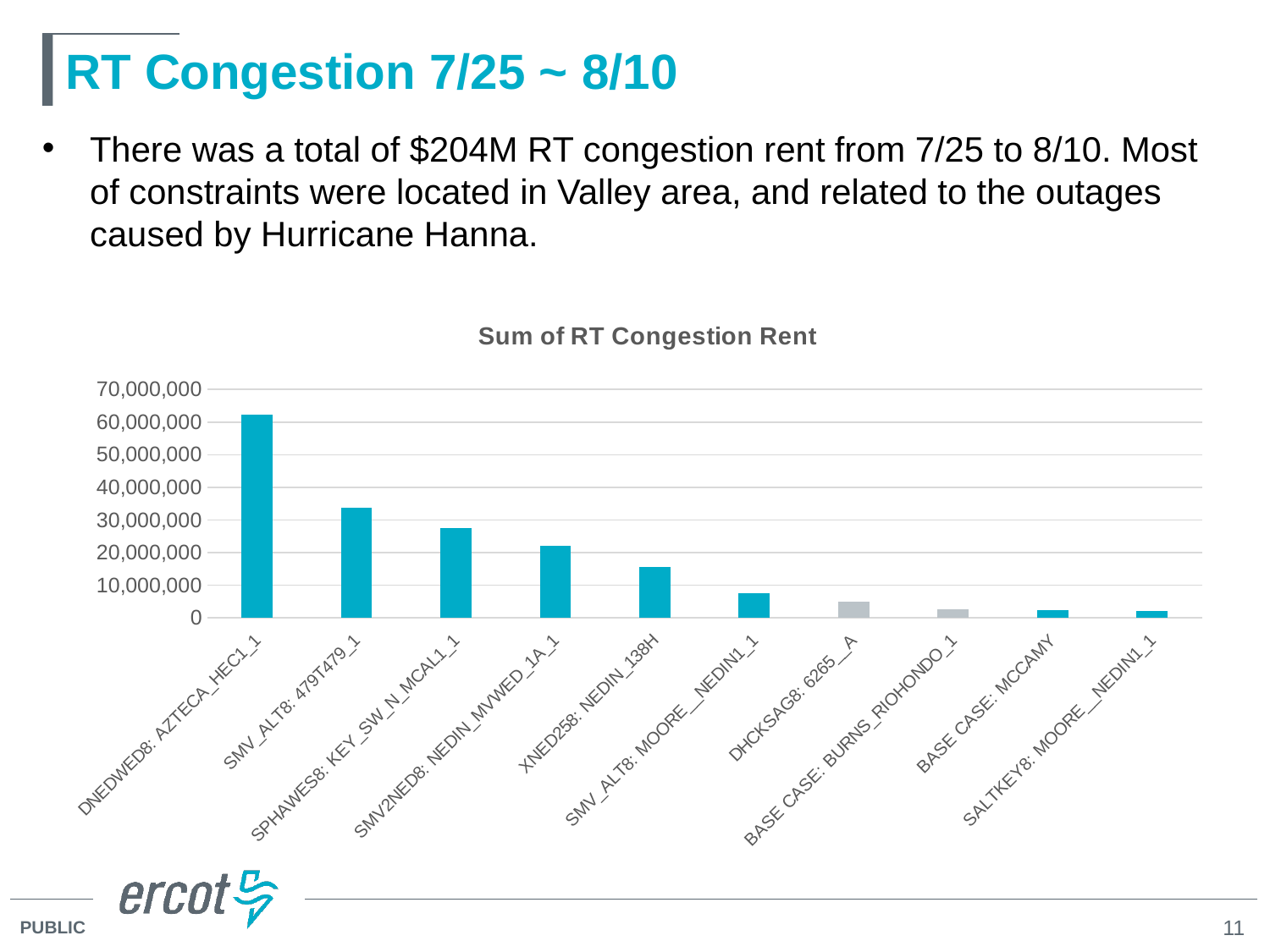
What is the title of the chart? Sum of RT Congestion Rent Is the value for DNEDWED8: AZTECA_HEC1_1 greater or less than 60,000,000? greater How many constraints (bars) are plotted in the chart? 10 Do the bar values rise or fall moving from left to right along the x axis? fall Is the value for SMV_ALT8: MOORE__NEDIN1_1 greater or less than 10,000,000? less Is the value for XNED258: NEDIN_138H greater or less than 20,000,000? less What kind of chart is shown on the slide? bar chart Which two bars are coloured grey instead of teal? DHCKSAG8: 6265__A and BASE CASE: BURNS_RIOHONDO_1 Which has a larger sum of RT congestion rent, SMV2NED8: NEDIN_MVWED_1A_1 or XNED258: NEDIN_138H? SMV2NED8: NEDIN_MVWED_1A_1 Which constraint has the highest sum of RT congestion rent? DNEDWED8: AZTECA_HEC1_1